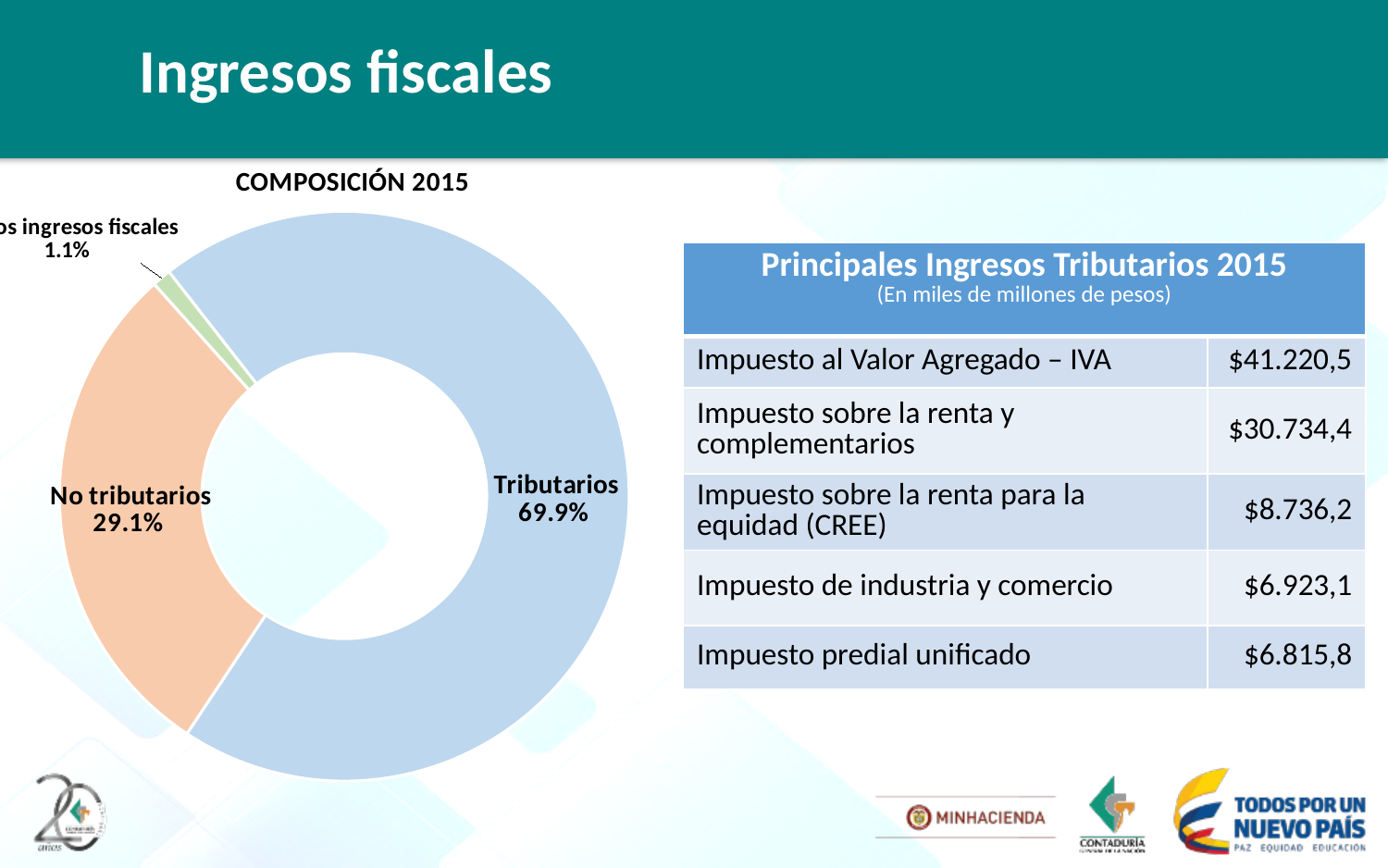
What is the percentage shown for the smallest slice in the COMPOSICIÓN 2015 chart? 1.1% What is the title of the chart on the slide? COMPOSICIÓN 2015 Is the share for No tributarios in the COMPOSICIÓN 2015 chart greater or less than 50%? less Which is larger in the COMPOSICIÓN 2015 chart, Tributarios or No tributarios? Tributarios What kind of chart is the COMPOSICIÓN 2015 chart? Doughnut (pie) chart Which category has the largest slice in the COMPOSICIÓN 2015 chart? Tributarios What colour is the Tributarios slice in the COMPOSICIÓN 2015 chart? Light blue How many slices does the COMPOSICIÓN 2015 chart have? 3 Do Tributarios and No tributarios together account for more or less than 90% of the COMPOSICIÓN 2015 chart? more By how many percentage points does Tributarios exceed No tributarios in the COMPOSICIÓN 2015 chart? 40.8 percentage points What is the share for No tributarios in the COMPOSICIÓN 2015 chart? 29.1% What is the share for Tributarios in the COMPOSICIÓN 2015 chart? 69.9%